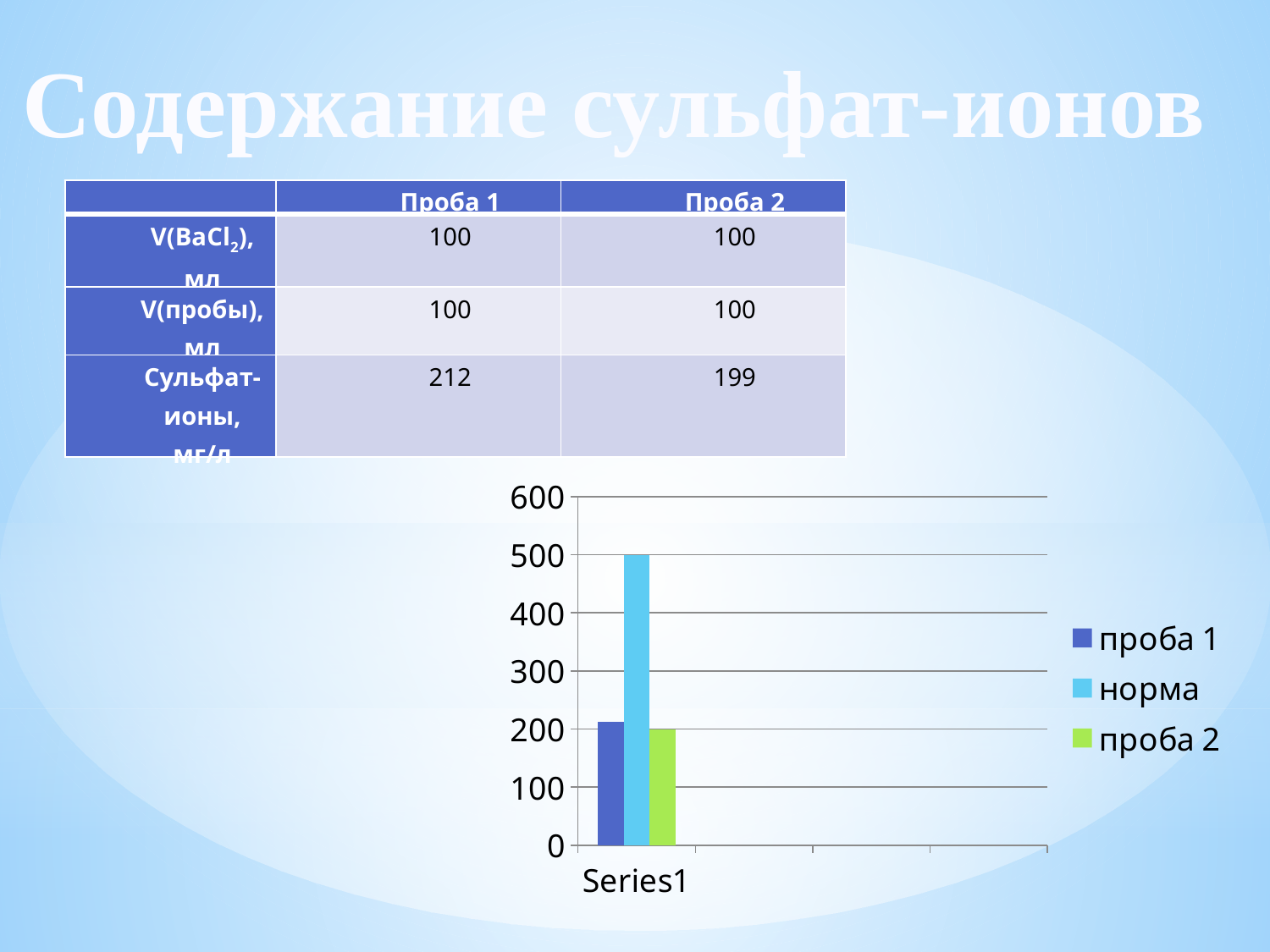
Is the value for проба 2 in the chart greater or less than 100? greater Is the value for норма in the chart greater or less than 400? greater What kind of chart is shown on the slide? bar chart Which is larger in the chart, проба 1 or норма? норма What is the highest value shown on the chart's vertical axis? 600 What is the value of the норма bar in the chart? 500 What is the label of the category on the x axis of the chart? Series1 How many series does the chart legend list? 3 Which series has the highest bar in the chart? норма Is the value for проба 1 in the chart greater or less than 300? less How many categories are shown on the x axis of the chart? 1